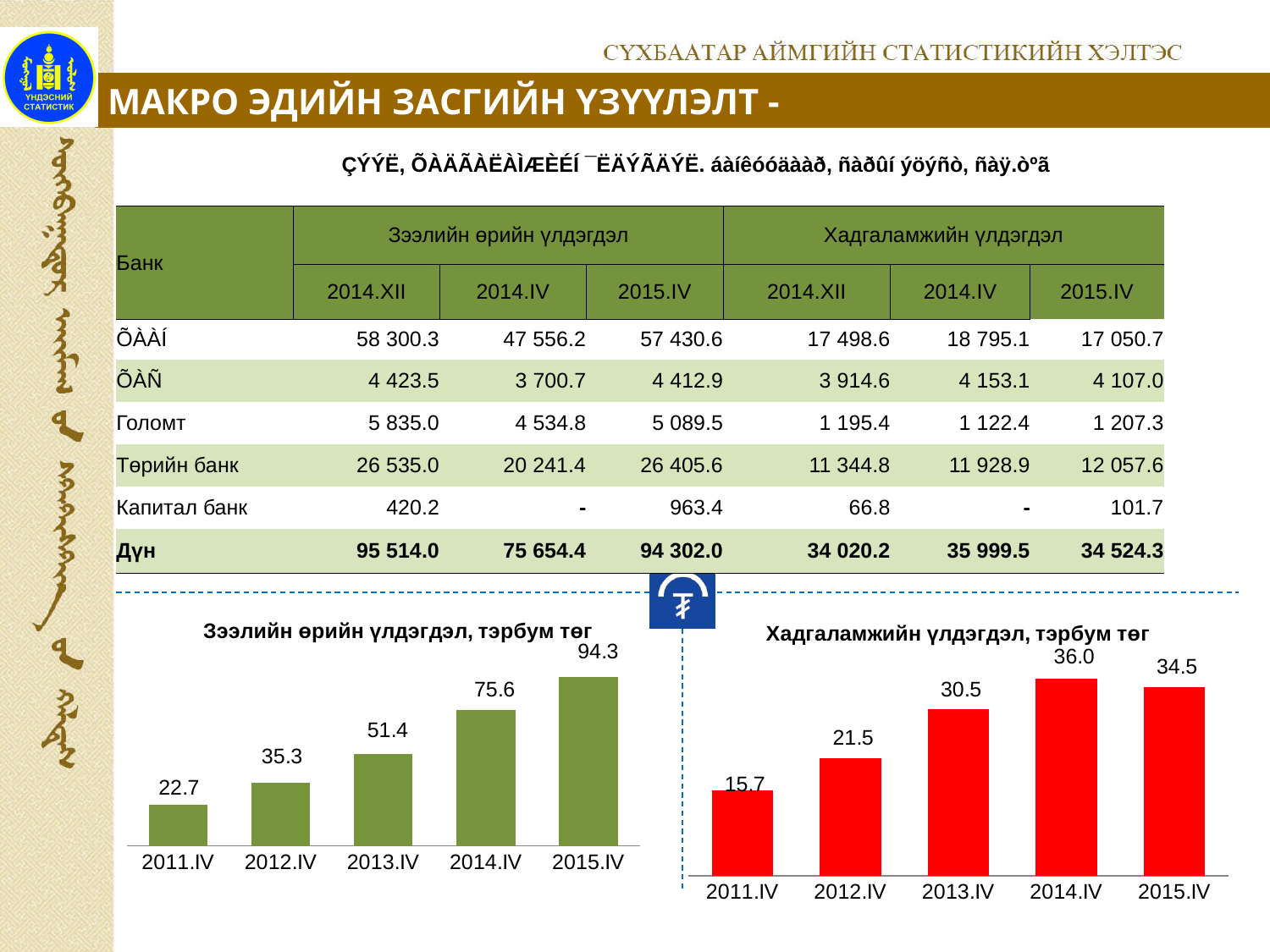
In the chart titled "Хадгаламжийн үлдэгдэл, тэрбум төг", what is the difference between the values for 2014.IV and 2015.IV? 1.5 What kind of chart is the chart titled "Хадгаламжийн үлдэгдэл, тэрбум төг"? Bar chart What colour are the bars in the chart titled "Хадгаламжийн үлдэгдэл, тэрбум төг"? Red In the chart titled "Хадгаламжийн үлдэгдэл, тэрбум төг", which period has the lowest value? 2011.IV In the chart titled "Хадгаламжийн үлдэгдэл, тэрбум төг", which is larger, the value for 2013.IV or 2012.IV? 2013.IV How many periods are shown on the x axis of the chart titled "Зээлийн өрийн үлдэгдэл, тэрбум төг"? 5 In the chart titled "Зээлийн өрийн үлдэгдэл, тэрбум төг", do the values rise or fall from 2011.IV to 2015.IV? Rise In the chart titled "Хадгаламжийн үлдэгдэл, тэрбум төг", which period has the highest value? 2014.IV In the chart titled "Хадгаламжийн үлдэгдэл, тэрбум төг", what is the value for 2012.IV? 21.5 In the chart titled "Зээлийн өрийн үлдэгдэл, тэрбум төг", what is the value for 2013.IV? 51.4 In the chart titled "Зээлийн өрийн үлдэгдэл, тэрбум төг", which period has the highest value? 2015.IV In the chart titled "Зээлийн өрийн үлдэгдэл, тэрбум төг", what is the difference between the values for 2015.IV and 2014.IV? 18.7